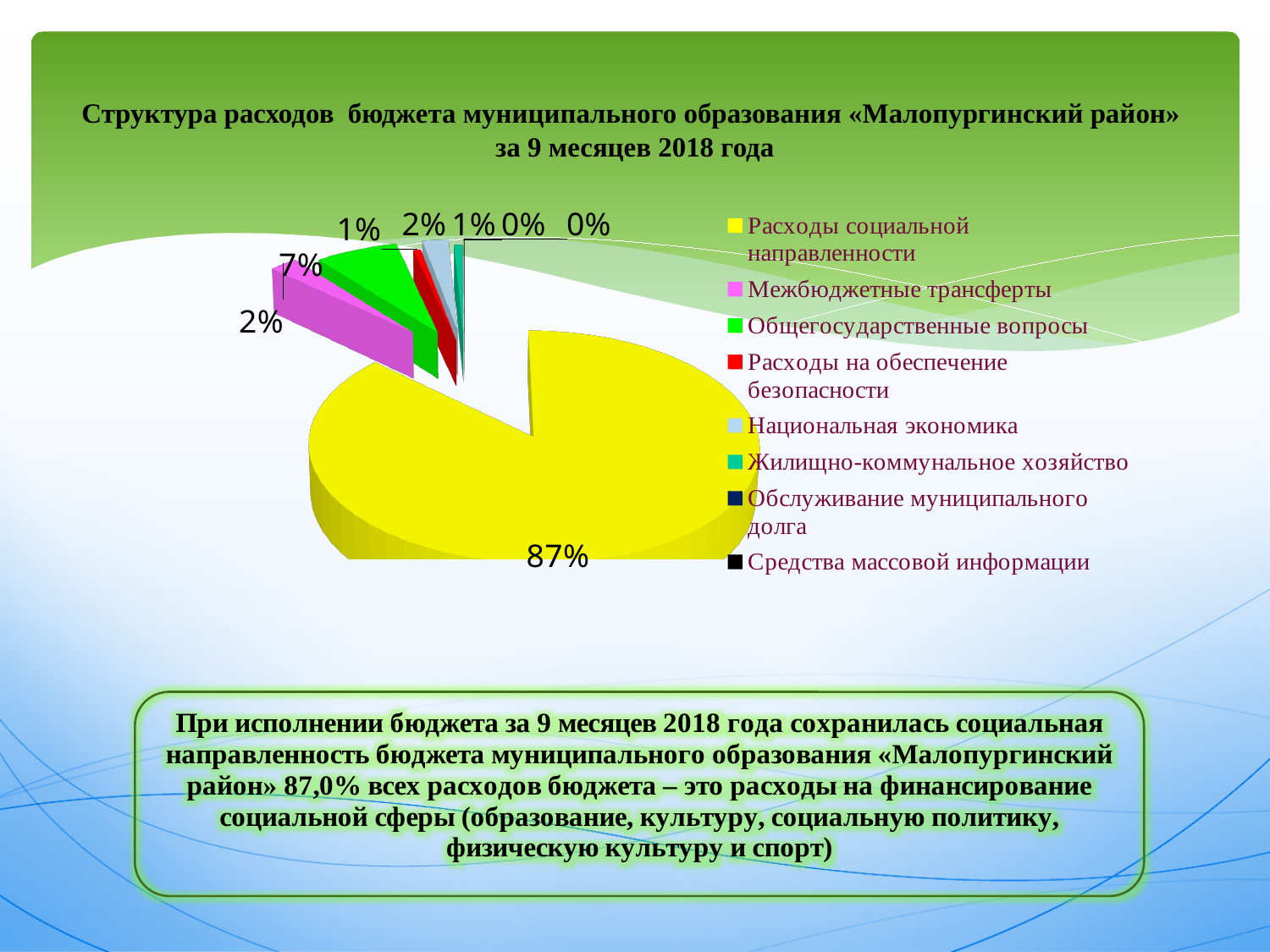
What share of the pie is labeled for Расходы социальной направленности? 87% What is the title of the chart on the slide? Структура расходов бюджета муниципального образования «Малопургинский район» за 9 месяцев 2018 года Is the share for Расходы социальной направленности greater or less than 50%? greater What type of chart is shown on the slide? pie chart What colour is the slice for Расходы социальной направленности? yellow What is the largest percentage label shown on the pie chart? 87% How many categories does the chart legend list? 8 Which category has the largest share of the pie? Расходы социальной направленности How many slices on the pie chart are labeled 0%? 2 Which is larger: the slice for Расходы социальной направленности or the slice for Межбюджетные трансферты? Расходы социальной направленности Which is larger: the slice for Межбюджетные трансферты or the slice for Общегосударственные вопросы? Общегосударственные вопросы